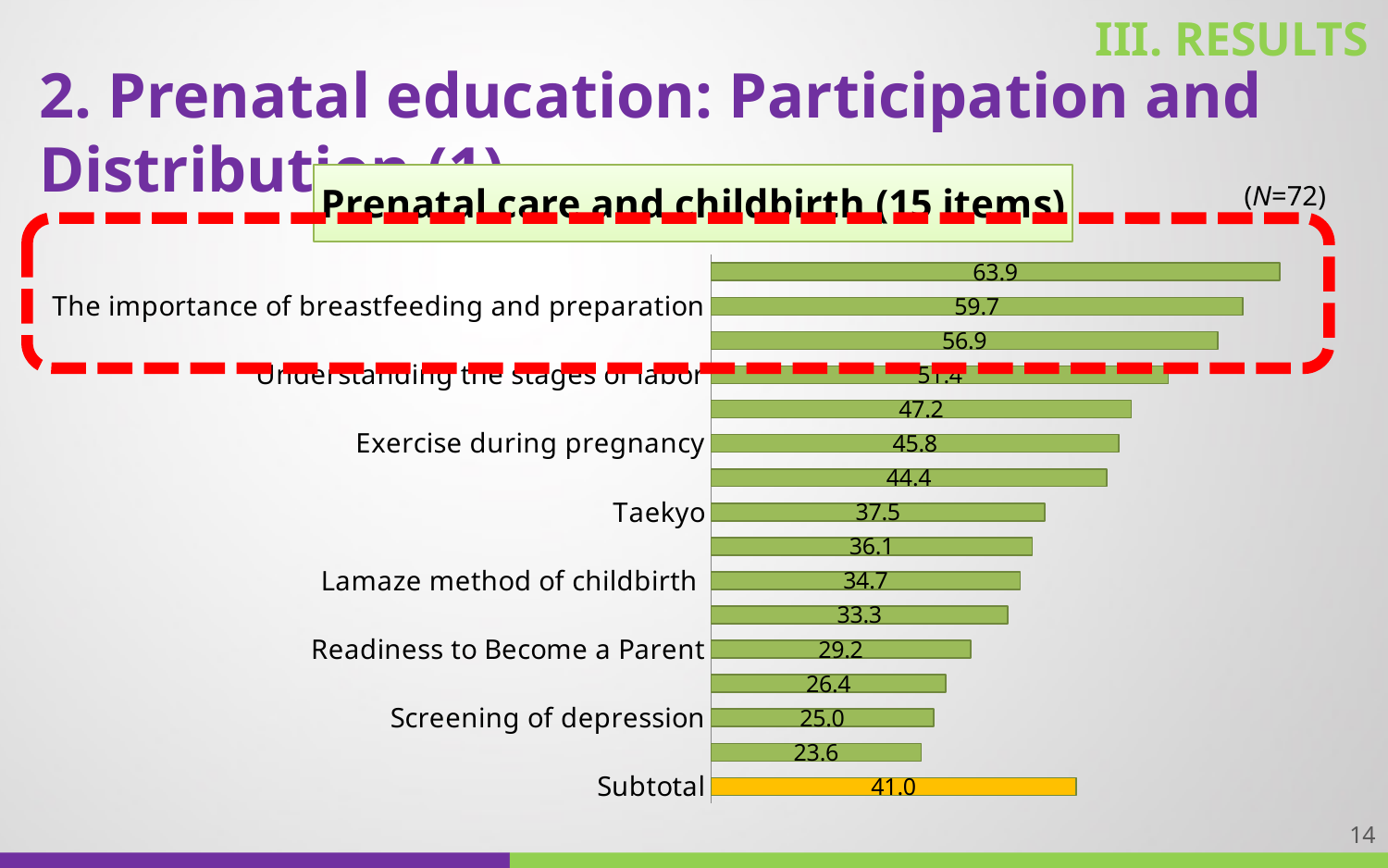
What is the value shown for "Exercise during pregnancy"? 45.8 What is the difference between the values for "Exercise during pregnancy" and "Taekyo"? 8.3 What is the value shown for "Screening of depression"? 25.0 What is the value shown for "Taekyo"? 37.5 What is the highest value printed on any bar in the chart? 63.9 What kind of chart is shown on the slide? Bar chart What is the value shown for "The importance of breastfeeding and preparation"? 59.7 What is the value of the "Subtotal" bar? 41.0 Among the items whose labels are readable, which has the lowest value? Screening of depression What is the value shown for "Lamaze method of childbirth"? 34.7 Which has the larger value, "Lamaze method of childbirth" or "Readiness to Become a Parent"? Lamaze method of childbirth What is the title of the chart? Prenatal care and childbirth (15 items)